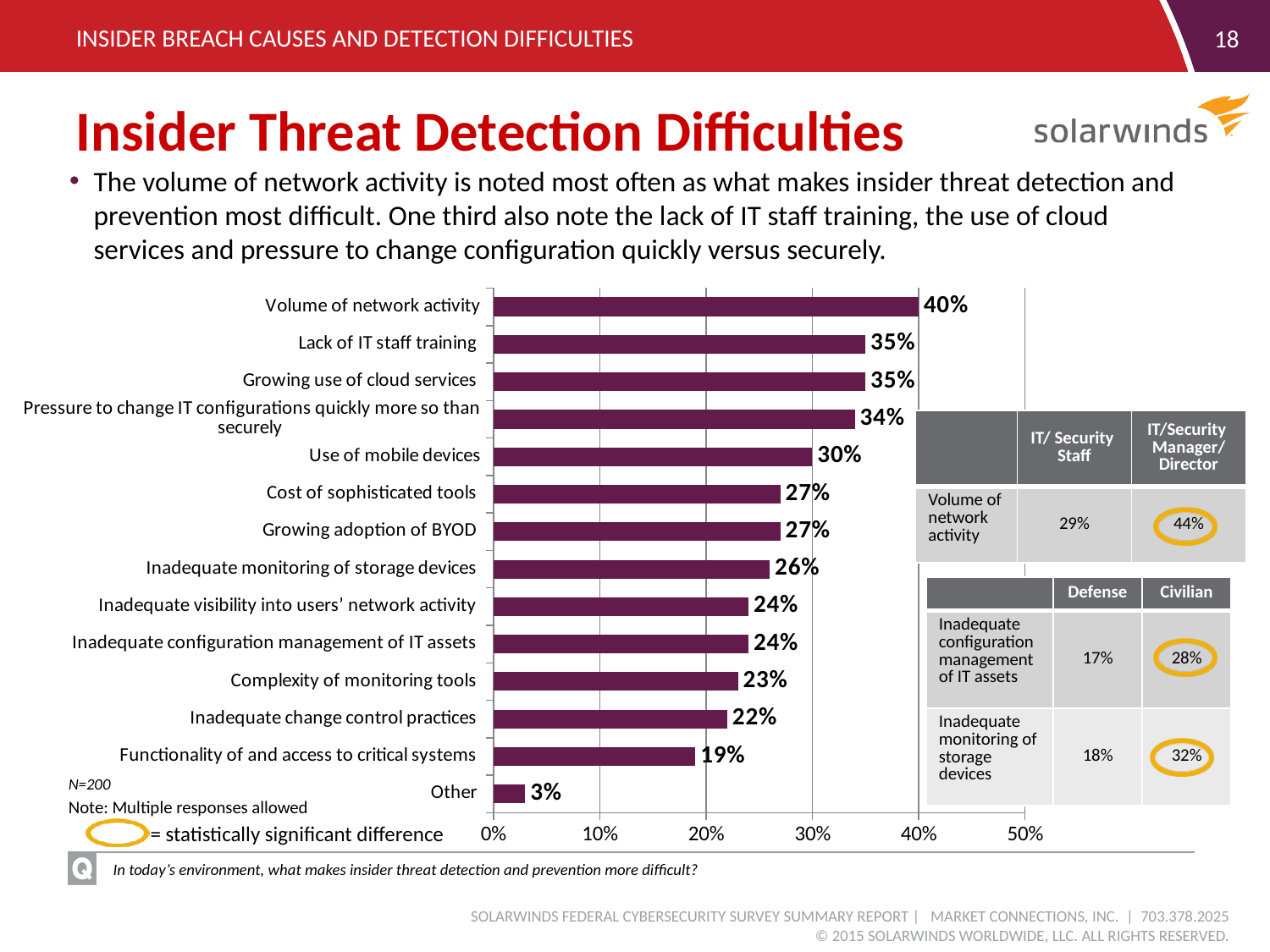
Is the value for Inadequate change control practices greater or less than 30%? less What is the value shown for Functionality of and access to critical systems? 19% What percentage of respondents cited Volume of network activity as making insider threat detection more difficult? 40% What is the value shown for Use of mobile devices? 30% How many categories are plotted in the bar chart? 14 Which is larger: the value for Cost of sophisticated tools or the value for Complexity of monitoring tools? Cost of sophisticated tools What kind of chart is used to show the detection difficulties? Bar chart What is the difference between the values for Growing use of cloud services and Other? 32% Which category has the lowest value in the bar chart? Other What is the difference between the values for Volume of network activity and Lack of IT staff training? 5% What is the highest value shown on the x axis of the bar chart? 50% Which category has the highest value in the bar chart? Volume of network activity